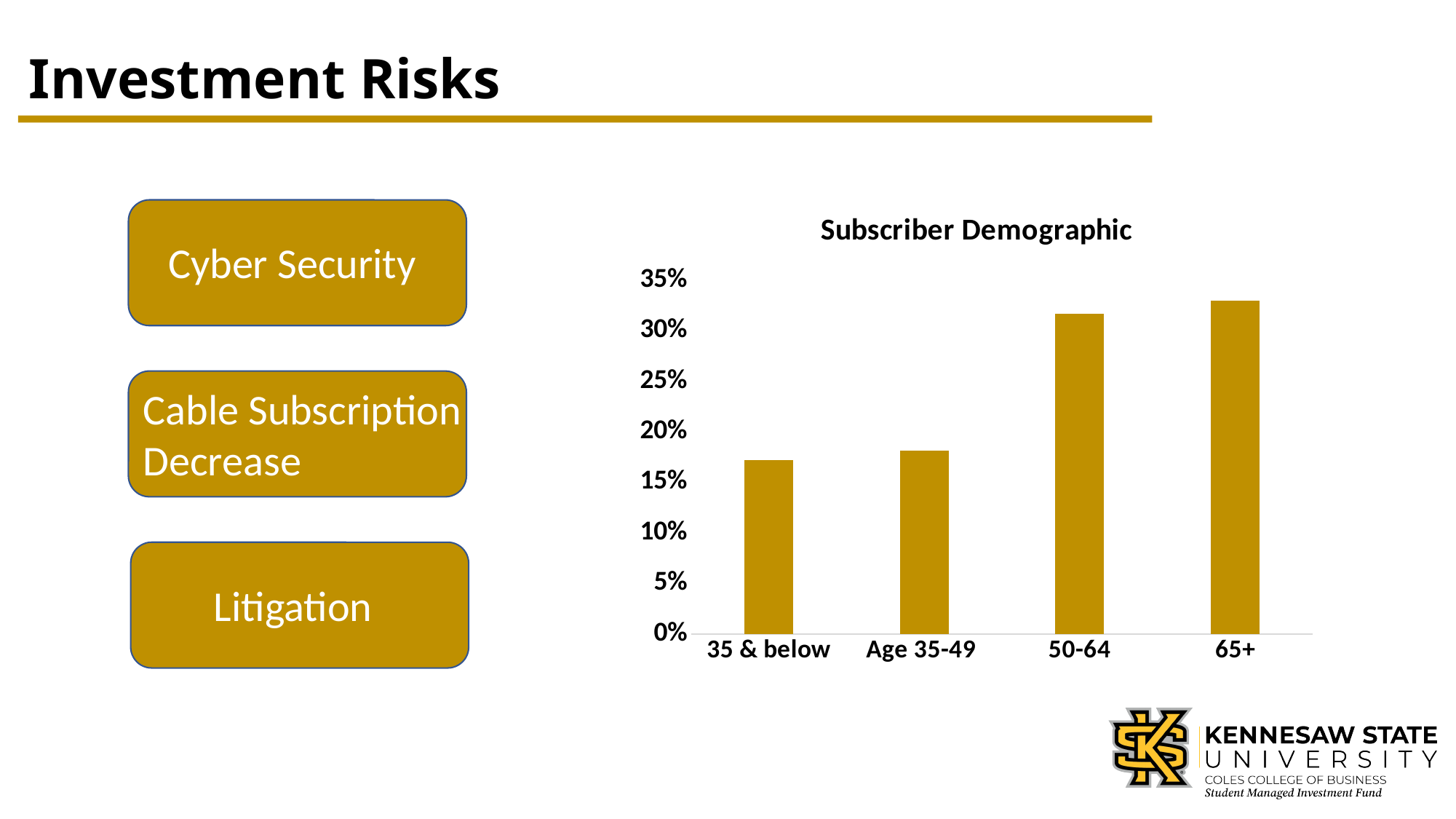
Is the value for Age 35-49 greater or less than 20%? less Which is larger in the Subscriber Demographic chart, the value for 50-64 or the value for Age 35-49? 50-64 What is the highest value shown on the y axis of the Subscriber Demographic chart? 35% Is the value for 35 & below greater or less than 20%? less Which age category has the highest value in the Subscriber Demographic chart? 65+ Do the values in the Subscriber Demographic chart rise or fall from left to right along the x axis? rise What kind of chart is the Subscriber Demographic chart? bar chart Is the value for 50-64 greater or less than 30%? greater What is the title of the chart on the slide? Subscriber Demographic How many age categories are shown in the Subscriber Demographic chart? 4